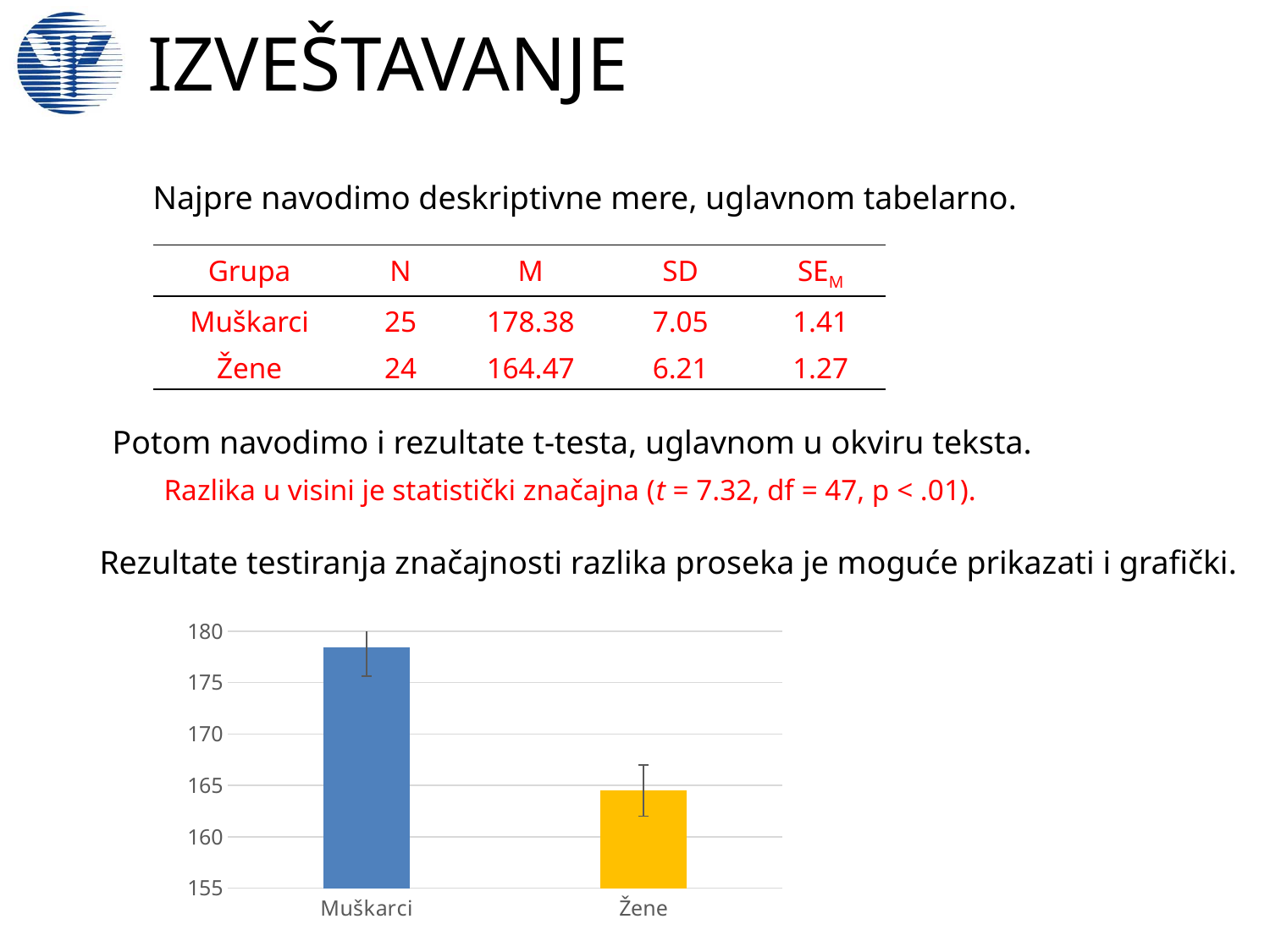
Is the bar for Muškarci greater or less than 175? greater Which category has the highest bar in the chart? Muškarci What colour is the bar for Žene? yellow How many categories are shown on the x axis of the bar chart? 2 Is the bar for Žene greater or less than 160? greater What is the lowest value shown on the y axis of the chart? 155 Which bar is taller, Muškarci or Žene? Muškarci Is the bar for Muškarci greater or less than 180? less Which category has the lowest bar in the chart? Žene What kind of chart is shown at the bottom of the slide? bar chart